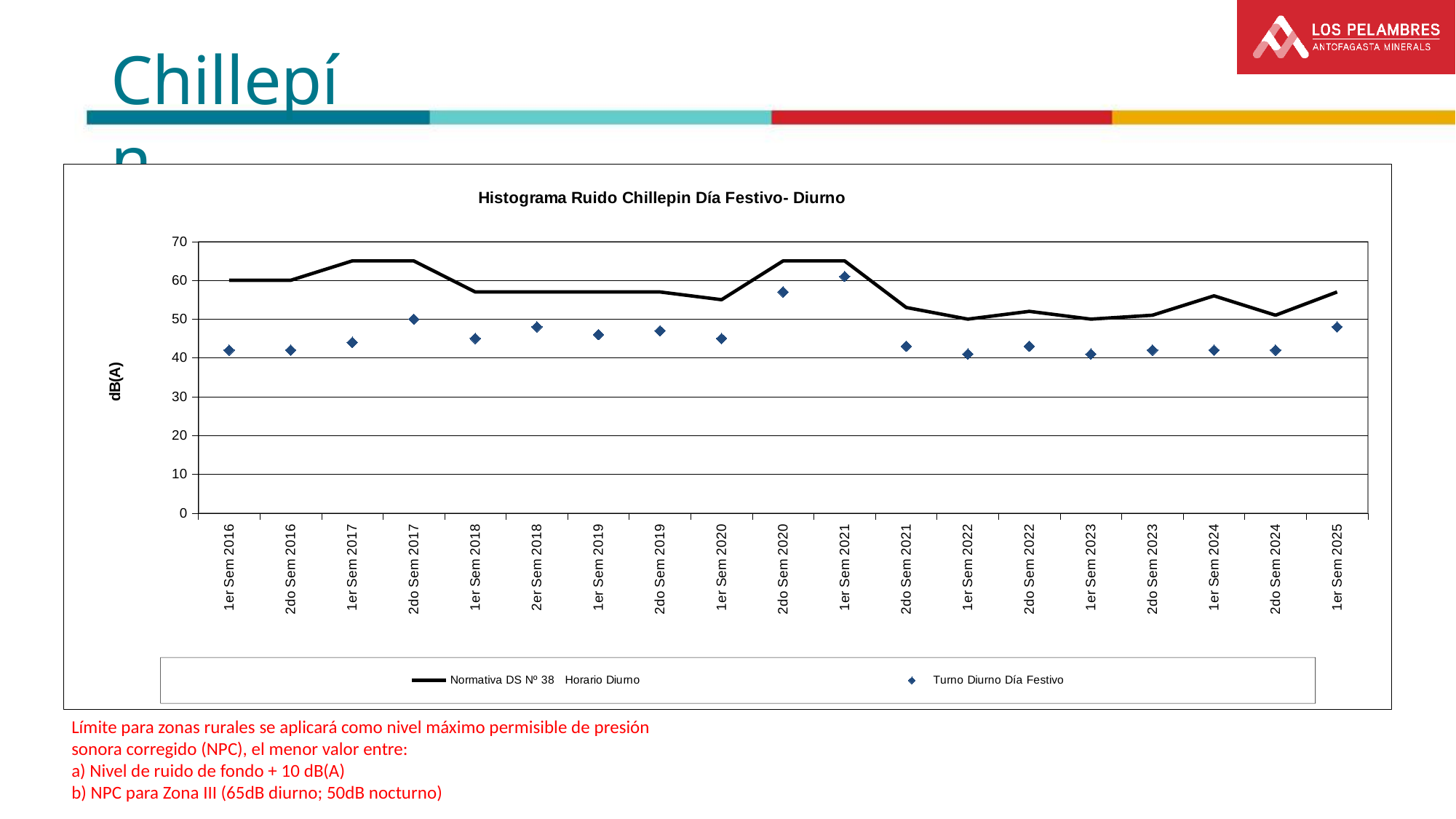
In which semester does the Turno Diurno Día Festivo series reach its highest value? 1er Sem 2021 Which has the larger Turno Diurno Día Festivo value, 2do Sem 2020 or 1er Sem 2016? 2do Sem 2020 What kind of chart is shown on the slide? line chart What is the label of the y axis of the chart? dB(A) Is the Turno Diurno Día Festivo value for 1er Sem 2016 greater or less than 50? less Which has the larger Turno Diurno Día Festivo value, 1er Sem 2025 or 1er Sem 2024? 1er Sem 2025 How many series does the chart legend list? 2 How many semester categories are shown on the x axis of the chart? 19 Is the Normativa DS Nº 38 Horario Diurno value for 1er Sem 2017 greater or less than 60? greater What is the title of the chart? Histograma Ruido Chillepin Día Festivo- Diurno Does the Normativa DS Nº 38 Horario Diurno line rise or fall from 1er Sem 2021 to 1er Sem 2022? fall Is the Turno Diurno Día Festivo value for 2do Sem 2020 greater or less than 50? greater